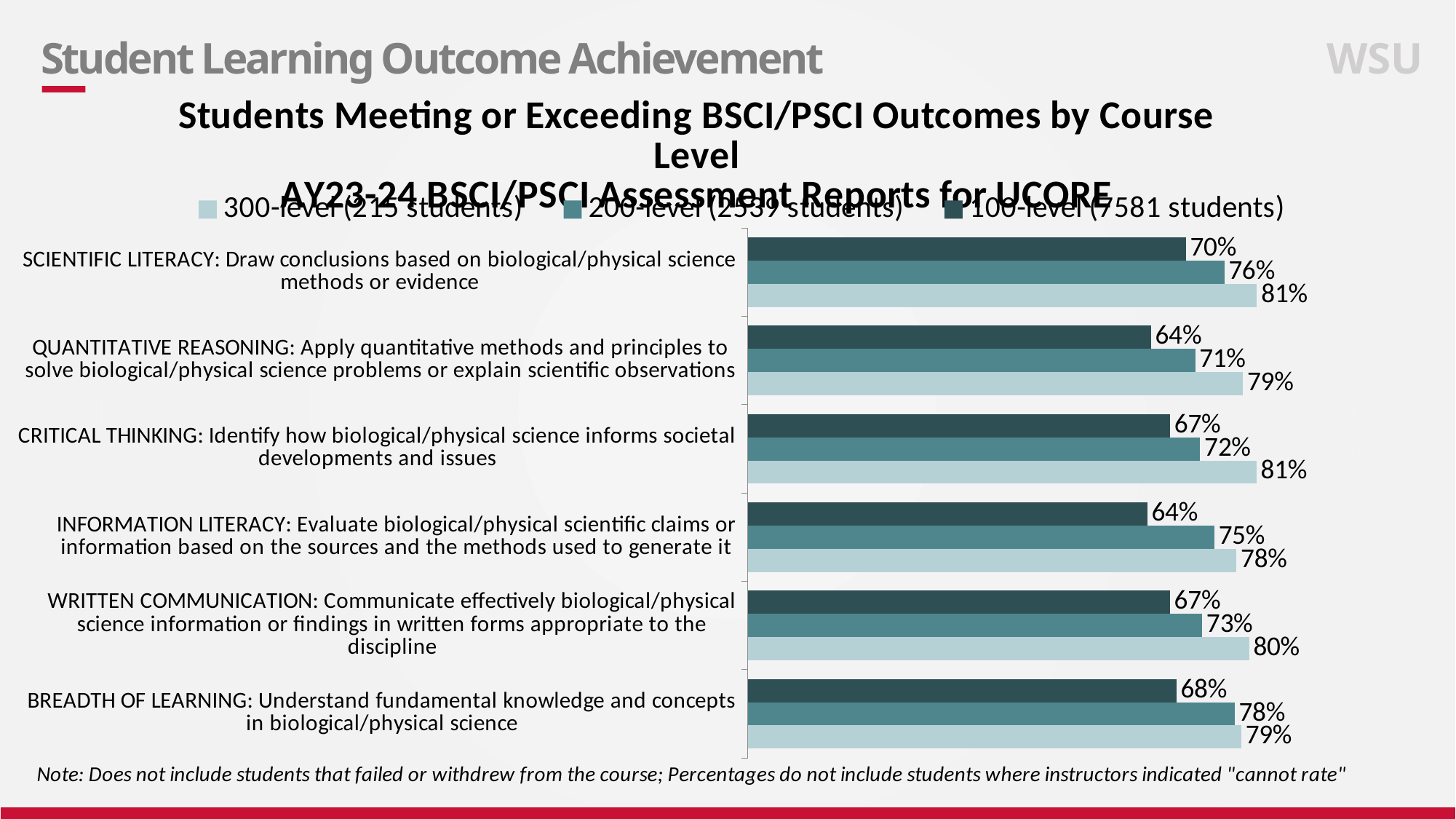
Which outcome has the highest value for 100-level students? SCIENTIFIC LITERACY What is the value for 300-level students on the CRITICAL THINKING outcome? 81% Which is larger: the 300-level value for WRITTEN COMMUNICATION or the 300-level value for INFORMATION LITERACY? WRITTEN COMMUNICATION How many series does the legend list? 3 What percentage of 200-level students met or exceeded the BREADTH OF LEARNING outcome? 78% According to the legend, how many students are in the 100-level group? 7581 students How many outcome categories are shown in the chart? 6 What is the difference between the 200-level and 100-level values for INFORMATION LITERACY? 11% What is the difference between the 300-level and 100-level values for QUANTITATIVE REASONING? 15% What percentage of 100-level students met or exceeded the SCIENTIFIC LITERACY outcome? 70% What kind of chart is shown on the slide? Bar chart Which outcome has the lowest value for 200-level students? QUANTITATIVE REASONING